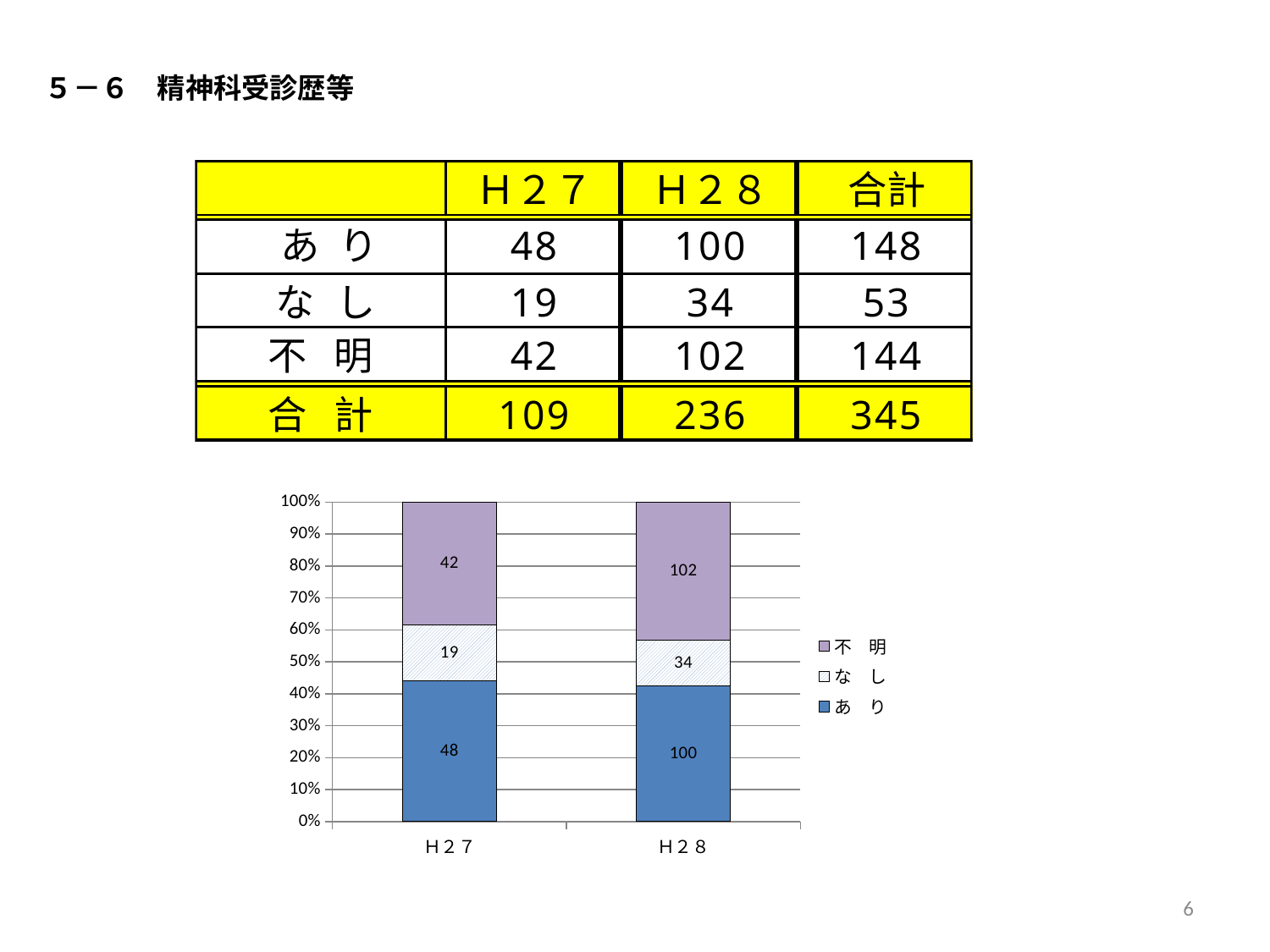
In the chart, which is larger for H28: あり or なし? あり In the chart, what is the value of なし for H27? 19 How many categories are shown on the x axis of the chart? 2 In the chart, what is the total of the stacked bar for H28? 236 In the chart, which series has the lowest value for H27? なし In the chart, what is the value of 不明 for H28? 102 In the chart, what is the difference between the あり values for H28 and H27? 52 In the chart, what is the total of the stacked bar for H27? 109 In the chart, what is the value of なし for H28? 34 In the chart, what is the value of あり for H27? 48 How many series does the chart legend list? 3 What kind of chart is shown on the slide? stacked bar chart